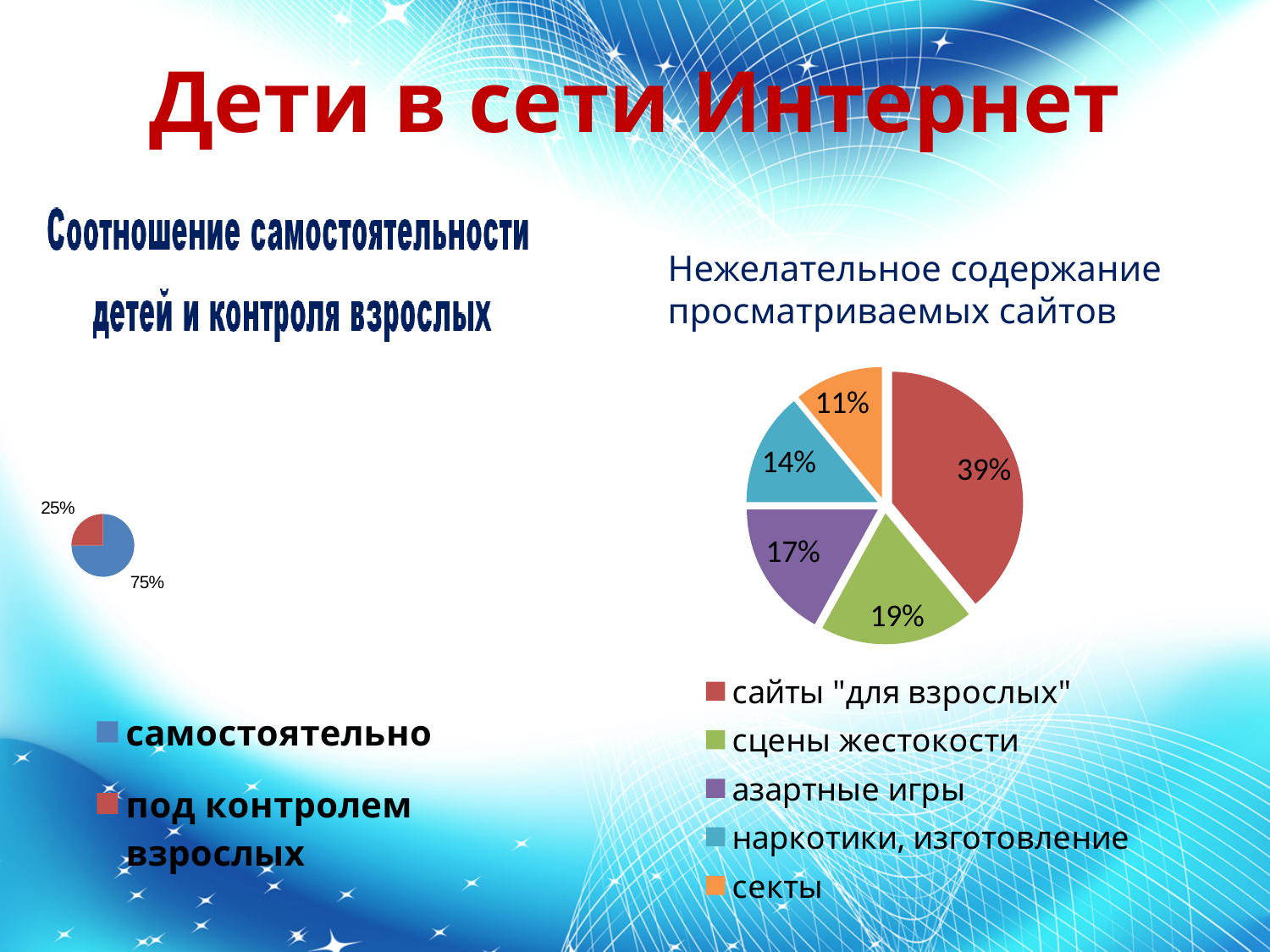
In the chart on the left ("Соотношение самостоятельности детей и контроля взрослых"), what share is labelled for "самостоятельно"? 75% In the chart "Нежелательное содержание просматриваемых сайтов", what is the difference in percentage points between "сцены жестокости" and "наркотики, изготовление"? 5 What type of chart is used for "Нежелательное содержание просматриваемых сайтов"? pie chart How many categories does the legend of the chart "Нежелательное содержание просматриваемых сайтов" list? 5 In the chart "Нежелательное содержание просматриваемых сайтов", what share is labelled for "азартные игры"? 17% In the chart "Нежелательное содержание просматриваемых сайтов", what share is labelled for "секты"? 11% In the chart on the left ("Соотношение самостоятельности детей и контроля взрослых"), what colour is the slice for "под контролем взрослых"? red In the chart "Нежелательное содержание просматриваемых сайтов", which is larger: "сцены жестокости" or "азартные игры"? сцены жестокости In the chart "Нежелательное содержание просматриваемых сайтов", which category has the largest slice? сайты "для взрослых" In the chart "Нежелательное содержание просматриваемых сайтов", which category has the smallest slice? секты In the chart "Нежелательное содержание просматриваемых сайтов", what share is labelled for "сайты "для взрослых""? 39% In the chart on the left ("Соотношение самостоятельности детей и контроля взрослых"), what share is labelled for "под контролем взрослых"? 25%